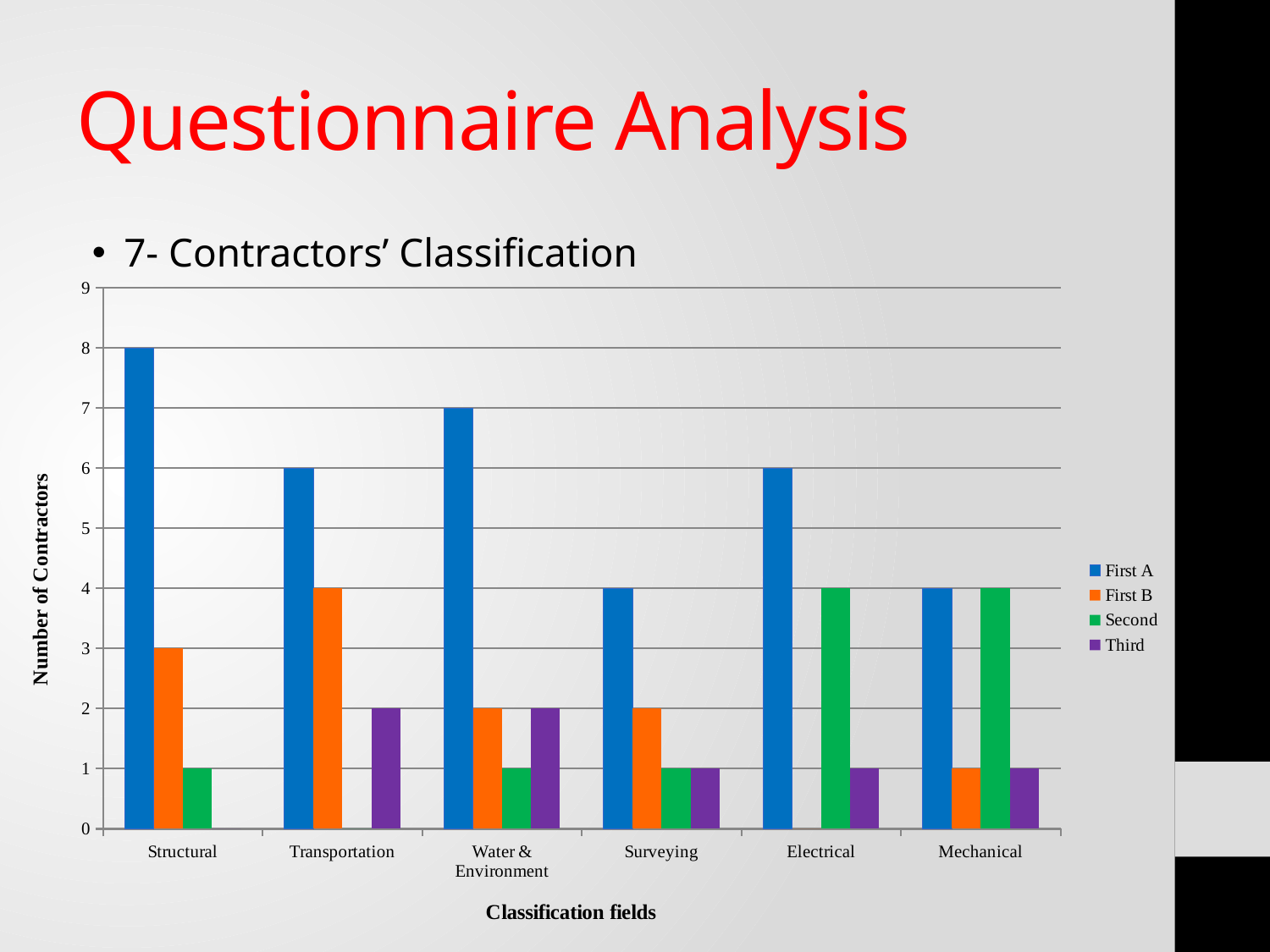
Which classification field has the highest number of First A contractors? Structural How many series does the legend list? 4 What is the number of Second contractors for Electrical? 4 Which classification field has the lowest number of First A contractors? Surveying and Mechanical What is the difference between the First A values for Structural and Surveying? 4 What is the number of First A contractors for Structural? 8 What type of chart is shown on the slide? Bar chart What is the number of First B contractors for Transportation? 4 What is the number of First A contractors for Water & Environment? 7 Which is larger, the Second value for Mechanical or the Second value for Surveying? Mechanical What is the label of the y axis? Number of Contractors How many classification fields are shown on the x axis? 6